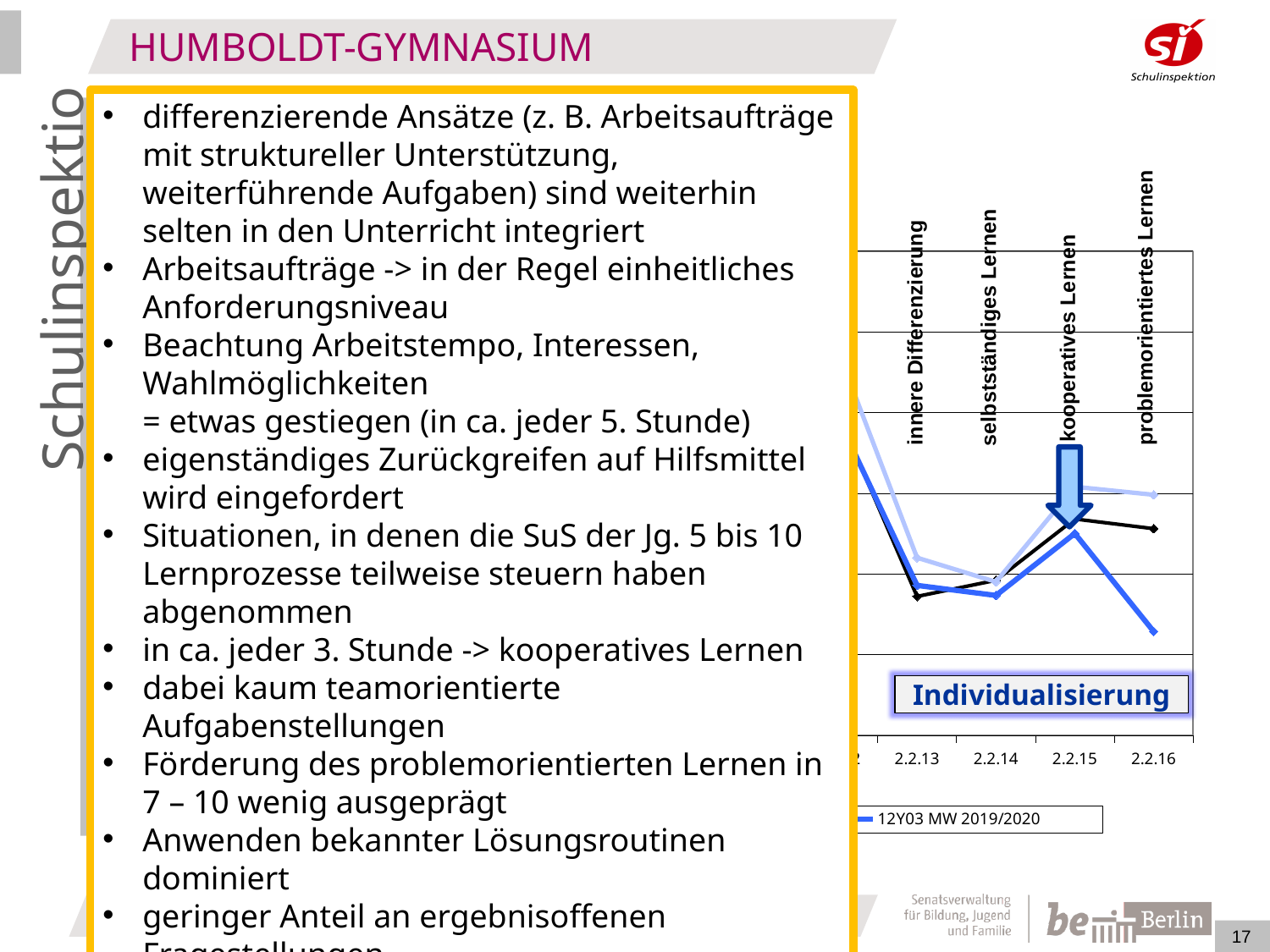
Does the black line rise or fall between 2.2.13 and 2.2.15? rise How many x-axis labels are fully readable on the chart? 4 Does the dark blue line rise or fall between 2.2.15 and 2.2.16? fall What kind of chart is shown on the right side of the slide? line chart Does the dark blue line rise or fall between 2.2.14 and 2.2.15? rise At 2.2.16, which line is higher: the light blue line or the dark blue line? light blue line At 2.2.16, which line is lower: the black line or the dark blue line? dark blue line Which category label on the chart corresponds to the x-axis position 2.2.15? kooperatives Lernen Which x-axis position does the large blue arrow on the chart point to? 2.2.15 Which category label on the chart corresponds to the x-axis position 2.2.16? problemorientiertes Lernen